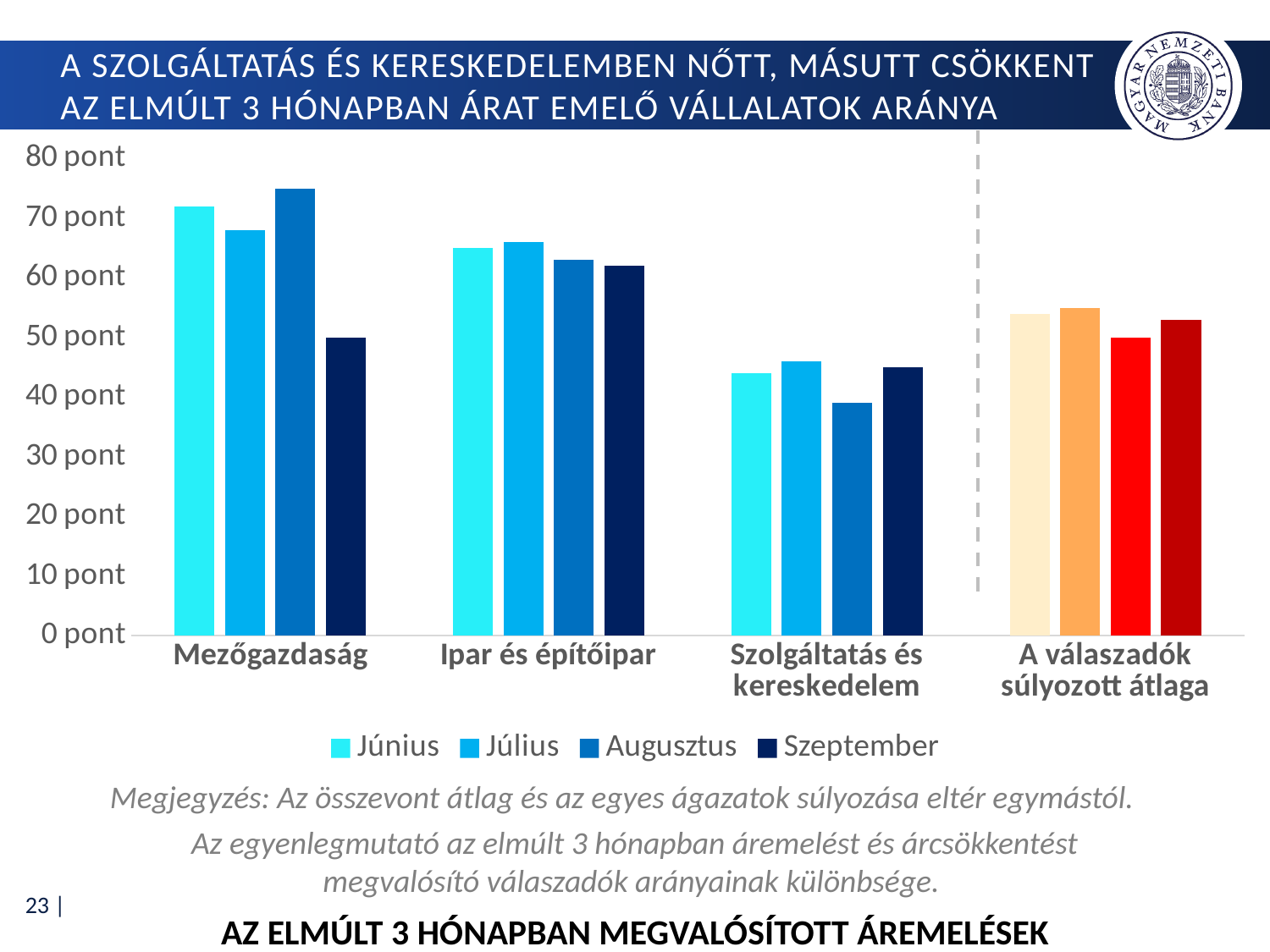
Which category has the lowest Szeptember value? Szolgáltatás és kereskedelem Is the Augusztus value for Szolgáltatás és kereskedelem greater or less than 50 pont? less For Mezőgazdaság, which is larger: the Június value or the Július value? Június How many series does the legend list? 4 What kind of chart is shown on the slide? bar chart Which month has the highest value for Mezőgazdaság? Augusztus For Szolgáltatás és kereskedelem, does the value rise or fall from Augusztus to Szeptember? rise Is the Szeptember value for Mezőgazdaság greater or less than 60 pont? less How many categories are shown on the x axis? 4 Which category is drawn with different colours (beige, orange and red) instead of the blue shades? A válaszadók súlyozott átlaga Which month has the lowest value for Szolgáltatás és kereskedelem? Augusztus Is the Augusztus value for Mezőgazdaság greater or less than 70 pont? greater